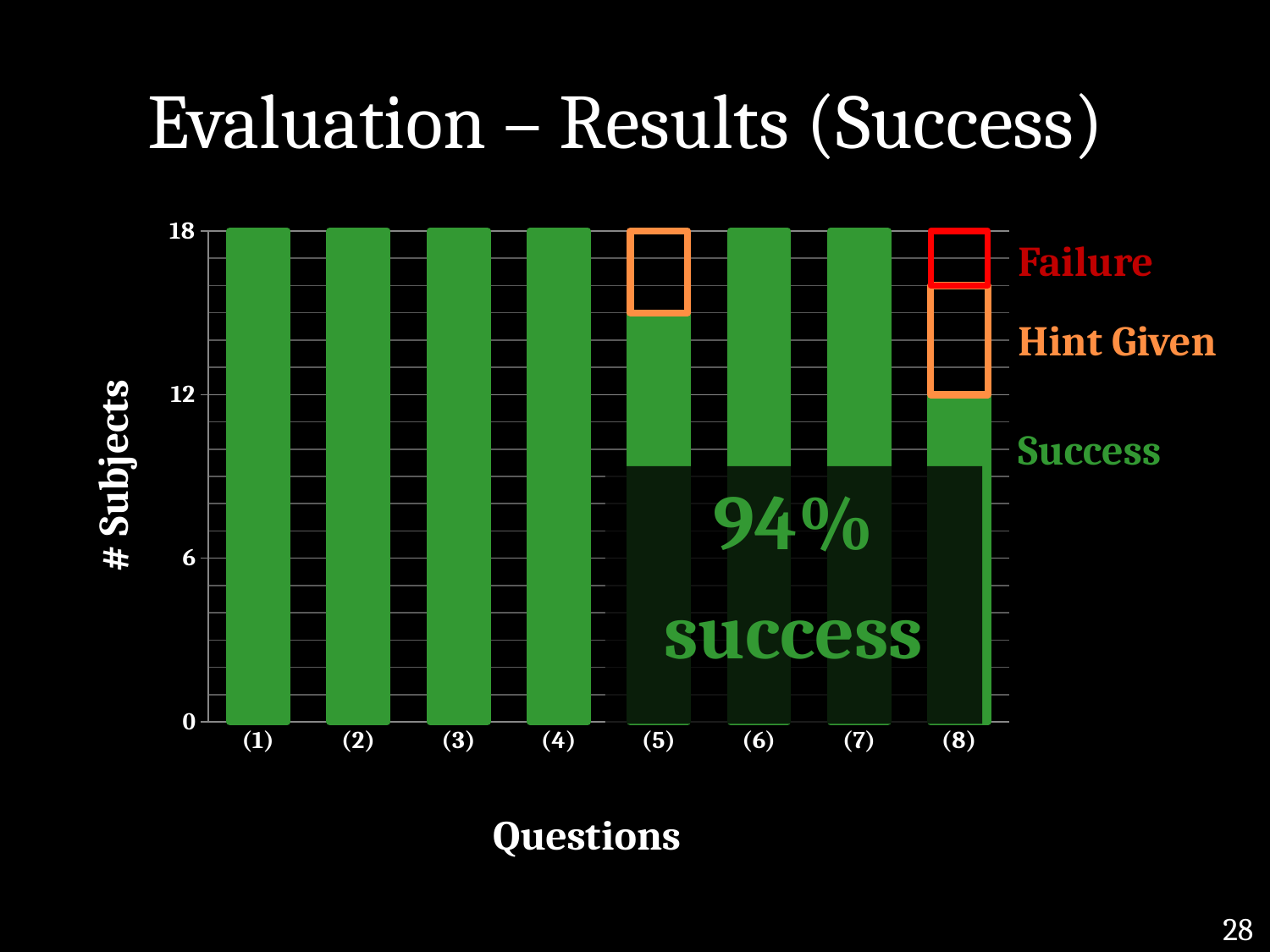
What kind of chart is shown on the slide? bar chart What is the title of the y axis? # Subjects How many subjects succeeded on question (1)? 18 Is the Success value for question (5) greater or less than 18? less Is the Success value for question (5) greater or less than 12? greater Which question has more Success subjects, (5) or (8)? (5) How many subjects succeeded on question (8)? 12 How many questions are shown along the x axis? 8 What is the total height of the stacked bar for question (8)? 18 Which question has the lowest number of Success subjects? (8) How many series does the legend list? 3 How many subjects succeeded on question (6)? 18